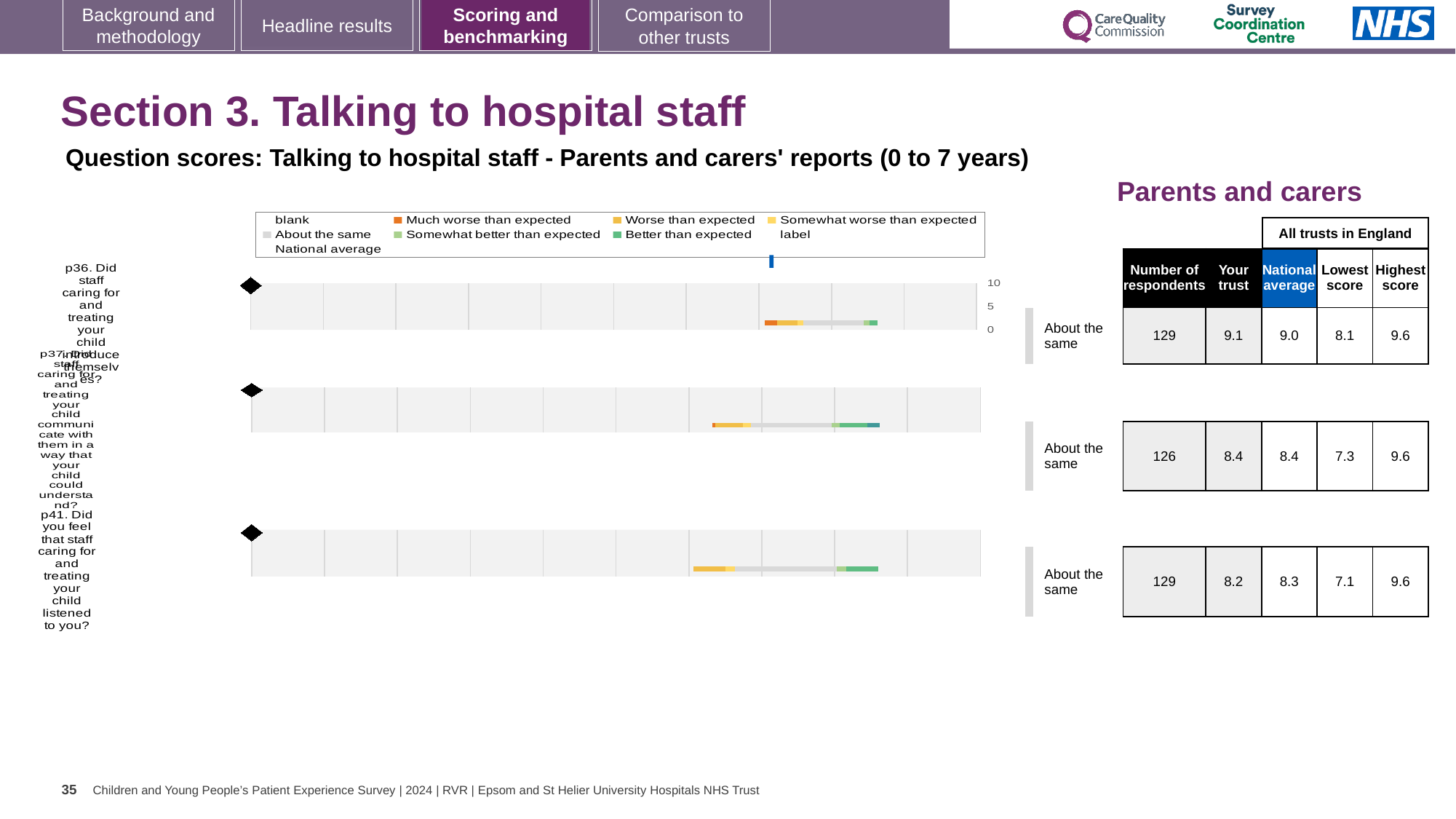
For the p37 chart, what is the difference between the highest score and the lowest score across all trusts in England? 2.3 Which of the three questions has the lowest 'Lowest score' across all trusts in England? p41 For the p37 chart (Did staff communicate with your child in a way they could understand?), how many respondents are there? 126 How many question rows (charts) are shown on the slide? 3 For the p36 chart (Did staff caring for and treating your child introduce themselves?), what is the 'Your trust' score? 9.1 For the p41 chart (Did you feel that staff listened to you?), what is the national average score? 8.3 In the chart legend, which colour represents 'Much worse than expected'? Orange For the p41 chart, which is higher: the 'Your trust' score or the national average? National average What kind of chart is used to show the question scores on this slide? Bar chart For the p36 chart, which is higher: the 'Your trust' score or the national average? Your trust Which of the three questions has the highest 'Your trust' score? p36 What is the highest tick value shown on the score axis of the charts? 10